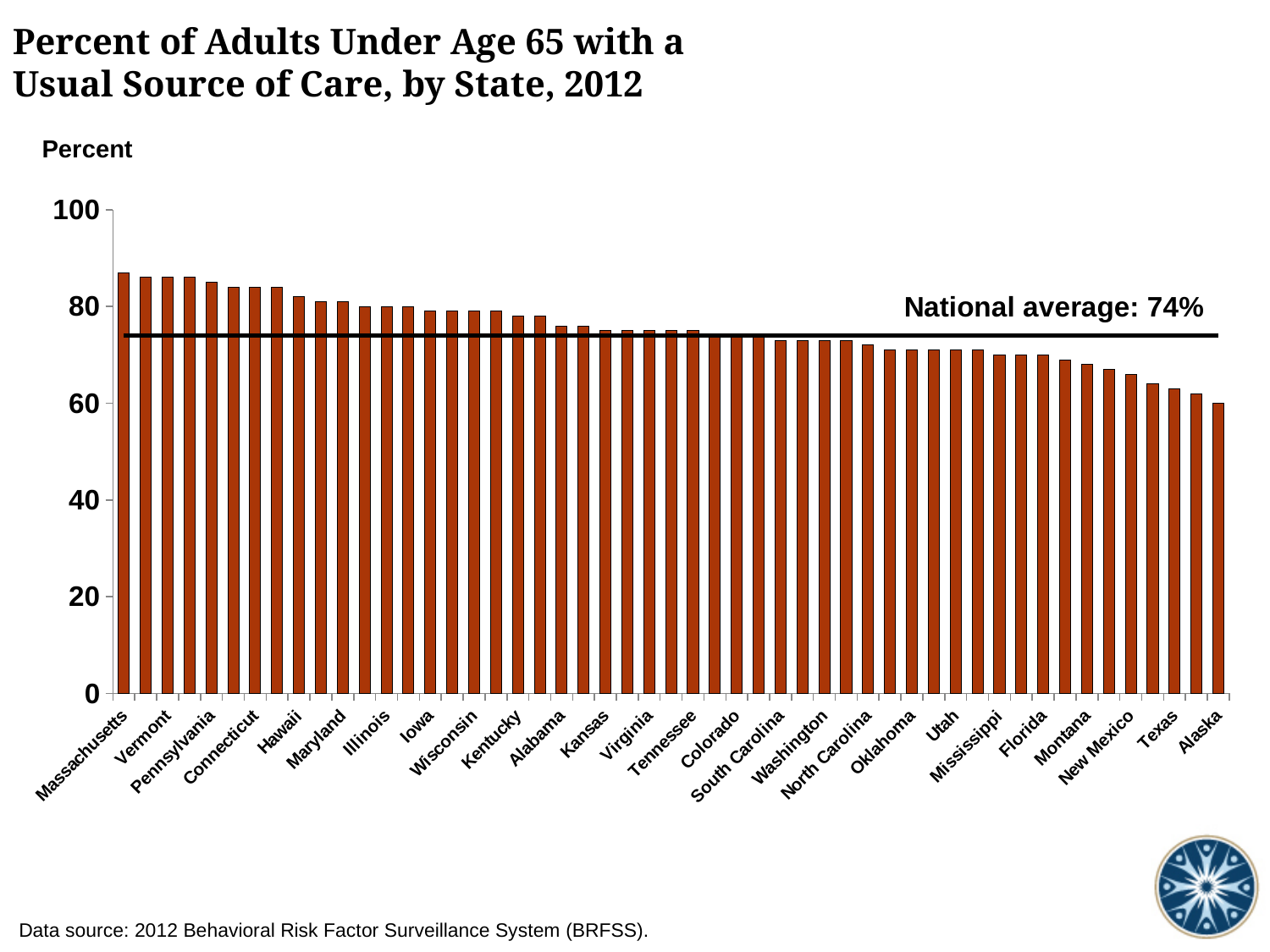
Do the bar values rise or fall moving from left to right across the chart? fall What kind of chart is shown on the slide? bar chart Is the value for Florida greater or less than 80? less What national average value is printed on the chart? 74% Which state has a higher value, Alaska or Hawaii? Hawaii What is the label on the vertical axis of the chart? Percent Is the value for Massachusetts greater or less than 80? greater Is the value for New Mexico greater or less than 60? greater Which state has a higher value, Vermont or Texas? Vermont Which state has the lowest percent of adults under age 65 with a usual source of care? Alaska Which state has the highest percent of adults under age 65 with a usual source of care? Massachusetts